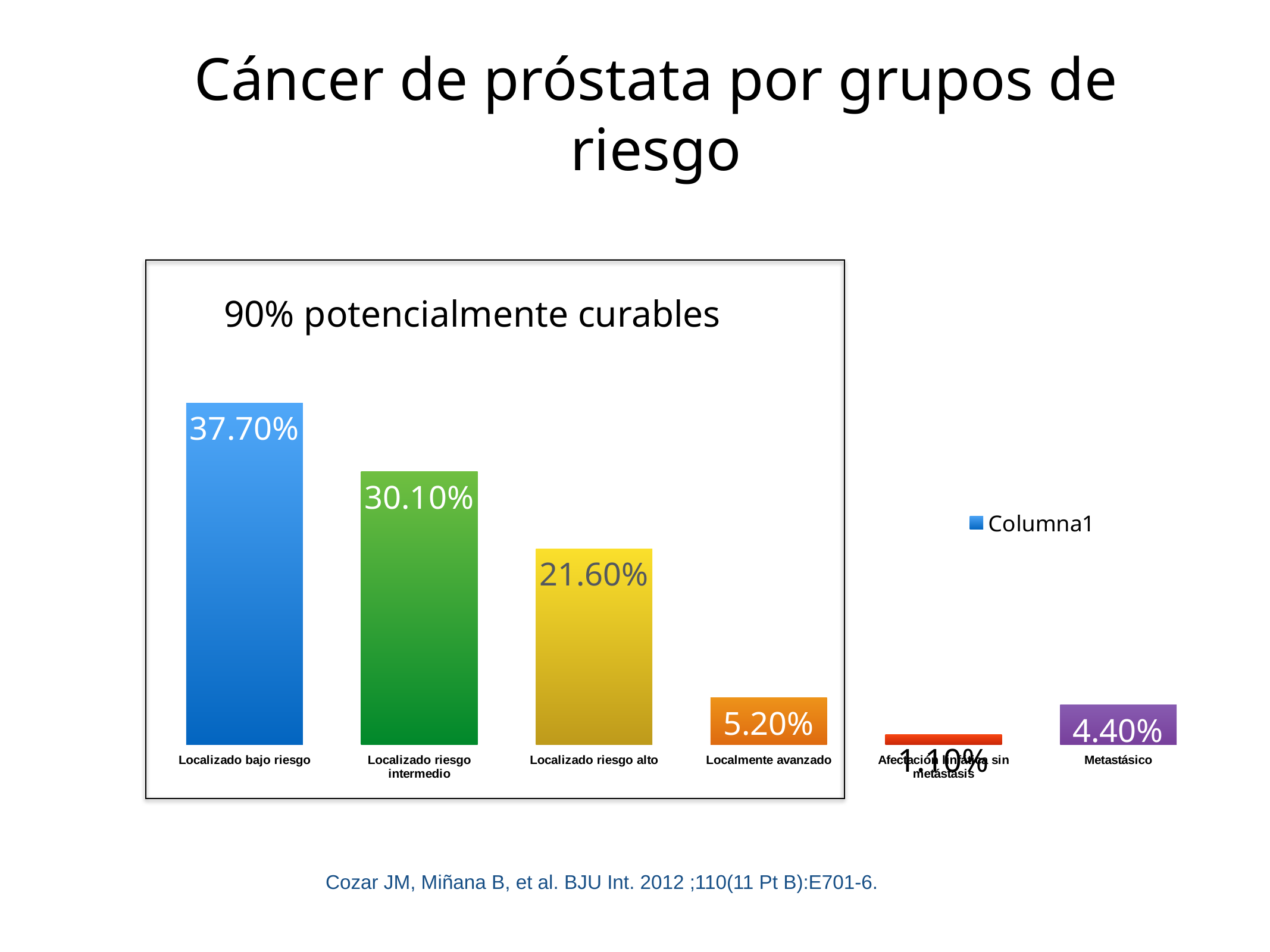
Which category has the highest value? Localizado bajo riesgo What is the value for Localizado bajo riesgo? 37.70% How many categories are shown in the chart? 6 What is the difference between the values for Localizado bajo riesgo and Localizado riesgo intermedio? 7.60% What is the value for Metastásico? 4.40% What kind of chart is shown on the slide? Bar chart Which is larger, the value for Localmente avanzado or the value for Metastásico? Localmente avanzado What is the value for Localizado riesgo alto? 21.60% Which category has the lowest value? Afectación linfática sin metástasis What series name does the legend show? Columna1 What is the value for Localmente avanzado? 5.20% What is the value for Localizado riesgo intermedio? 30.10%